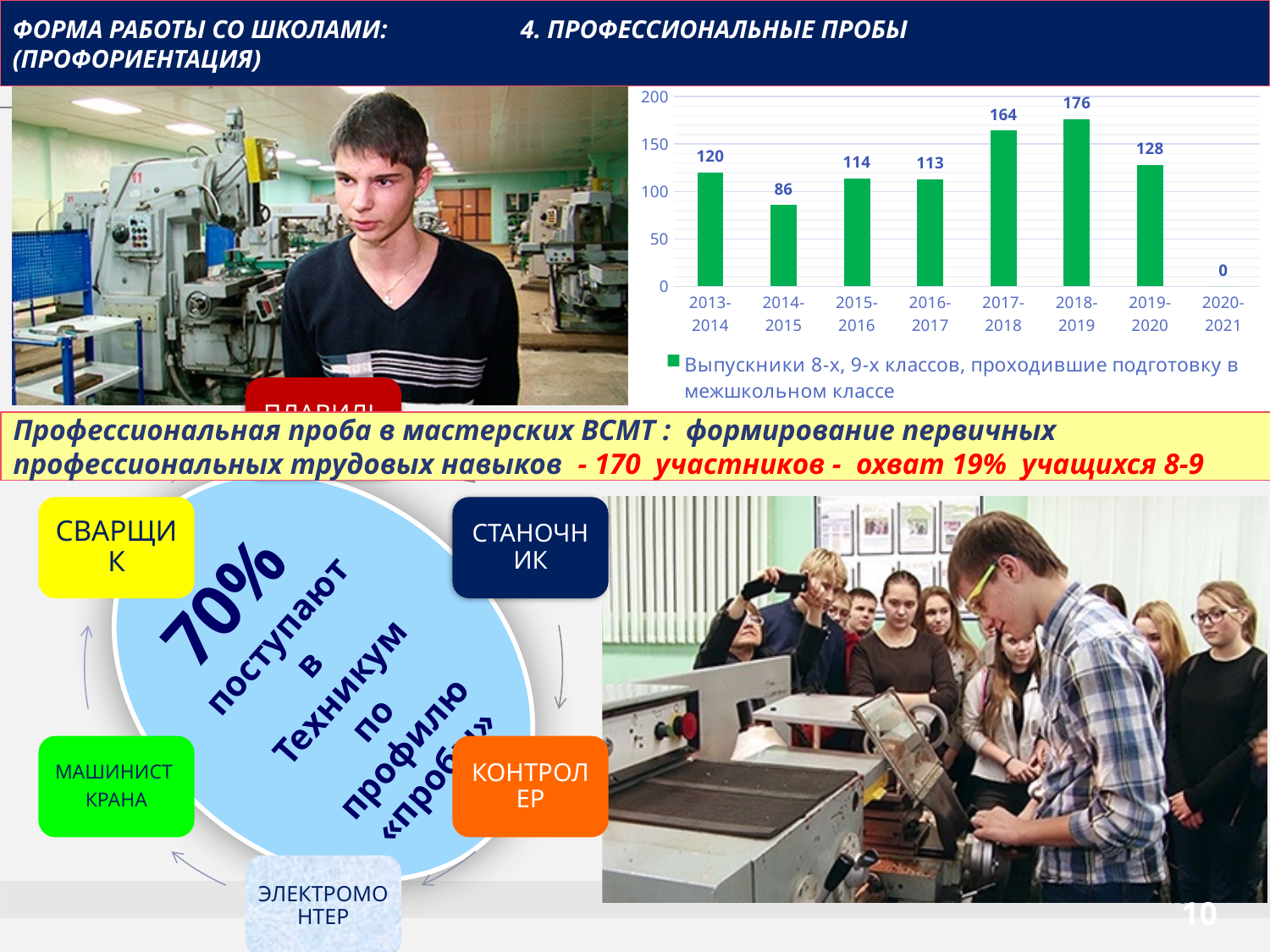
What is the difference between the values for 2018-2019 and 2017-2018? 12 What is the value for 2020-2021? 0 How many series does the legend list? 1 What kind of chart is shown on the slide? bar chart Which year has the highest value? 2018-2019 What is the value for 2018-2019? 176 Which year has the lowest value? 2020-2021 What is the difference between the values for 2013-2014 and 2014-2015? 34 What is the value for 2013-2014? 120 Which is larger, the value for 2019-2020 or the value for 2014-2015? 2019-2020 How many year categories are shown on the x axis? 8 Is the value for 2017-2018 greater or less than 150? greater